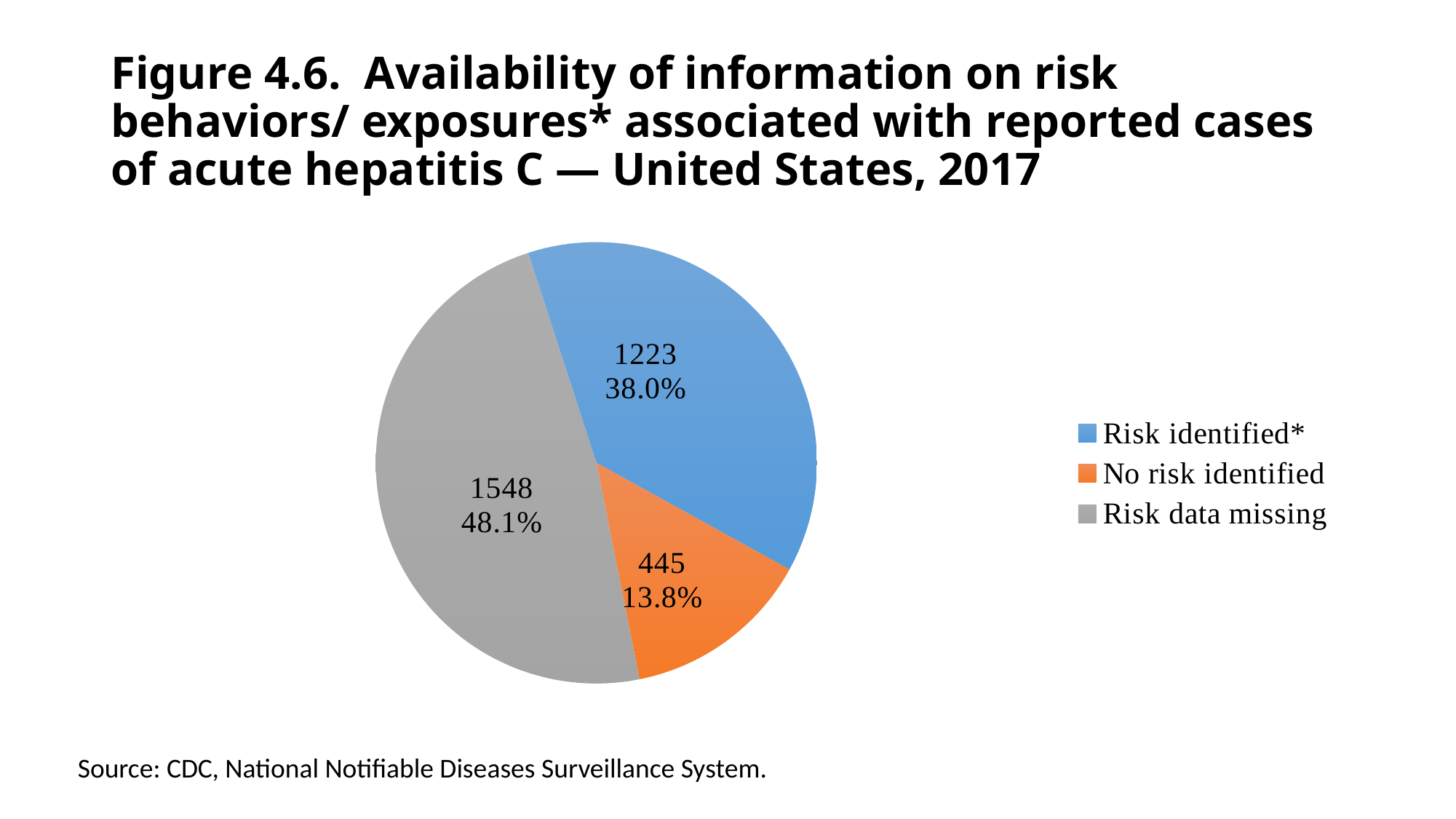
What share of the pie does 'No risk identified' represent? 13.8% How many cases are in the 'Risk identified*' slice? 1223 Which category has the smallest slice of the pie? No risk identified What is the difference in number of cases between 'Risk data missing' and 'Risk identified*'? 325 Which category has the largest slice of the pie? Risk data missing How many categories does the legend list? 3 How many cases are in the 'Risk data missing' slice? 1548 What share of the pie does 'Risk identified*' represent? 38.0% What percentage of cases had risk data missing? 48.1% Which is larger: the number of cases with 'Risk identified*' or with 'No risk identified'? Risk identified* How many cases are in the 'No risk identified' slice? 445 What type of chart is shown on the slide? pie chart